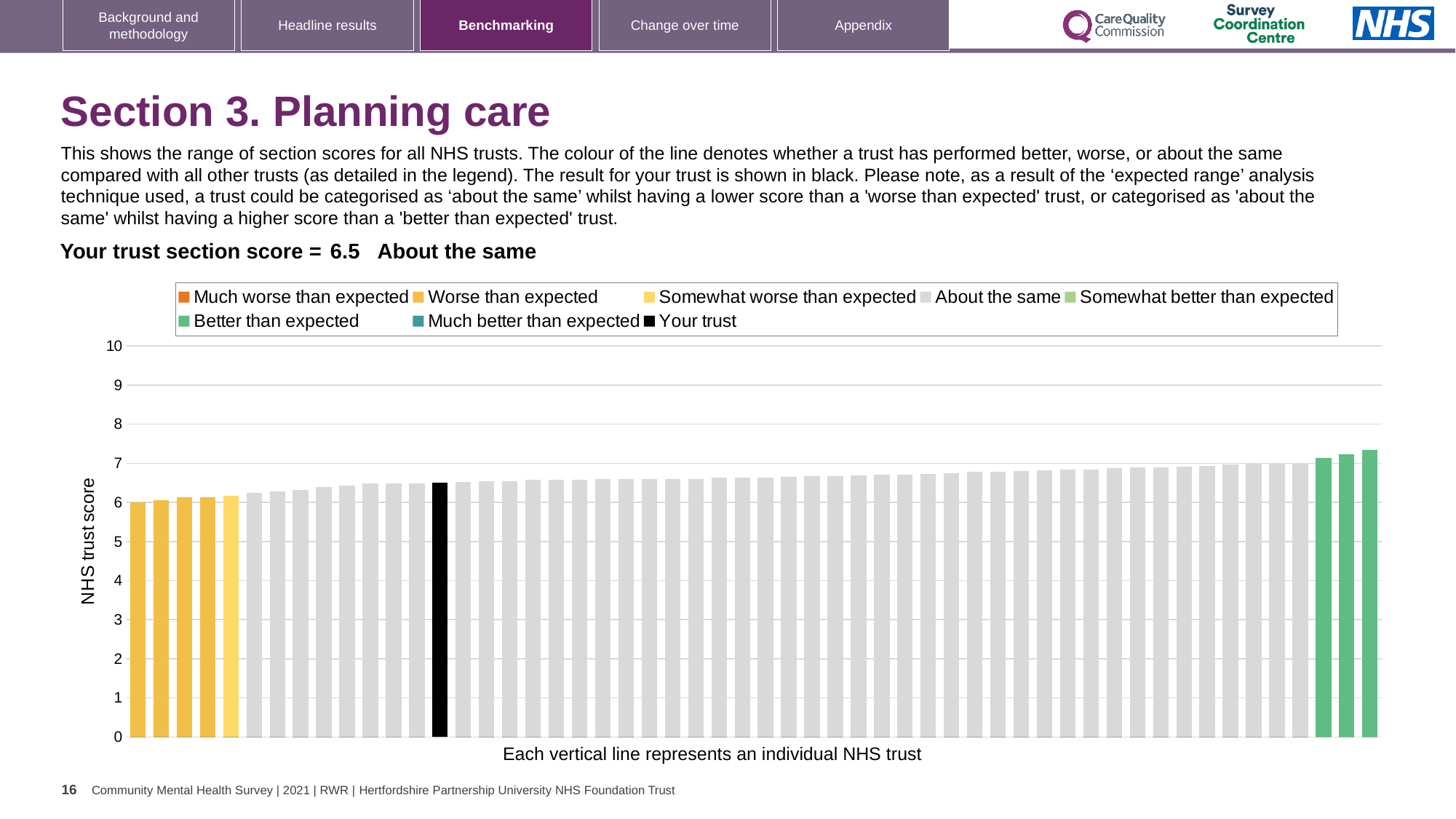
What colour is the bar representing your trust? black How many bars are coloured green (better than expected)? 3 Is the value of the rightmost (highest) bar greater or less than 7? greater Is the value for your trust greater or less than 7? less Is your trust's bar higher or lower than the rightmost bar? lower Is the value for your trust greater or less than 6? greater What kind of chart is shown on the slide? bar chart Do the bar values rise or fall from left to right along the x axis? rise What is the section score for your trust shown on the slide? 6.5 What is the label on the vertical axis of the chart? NHS trust score How many entries does the chart legend list? 8